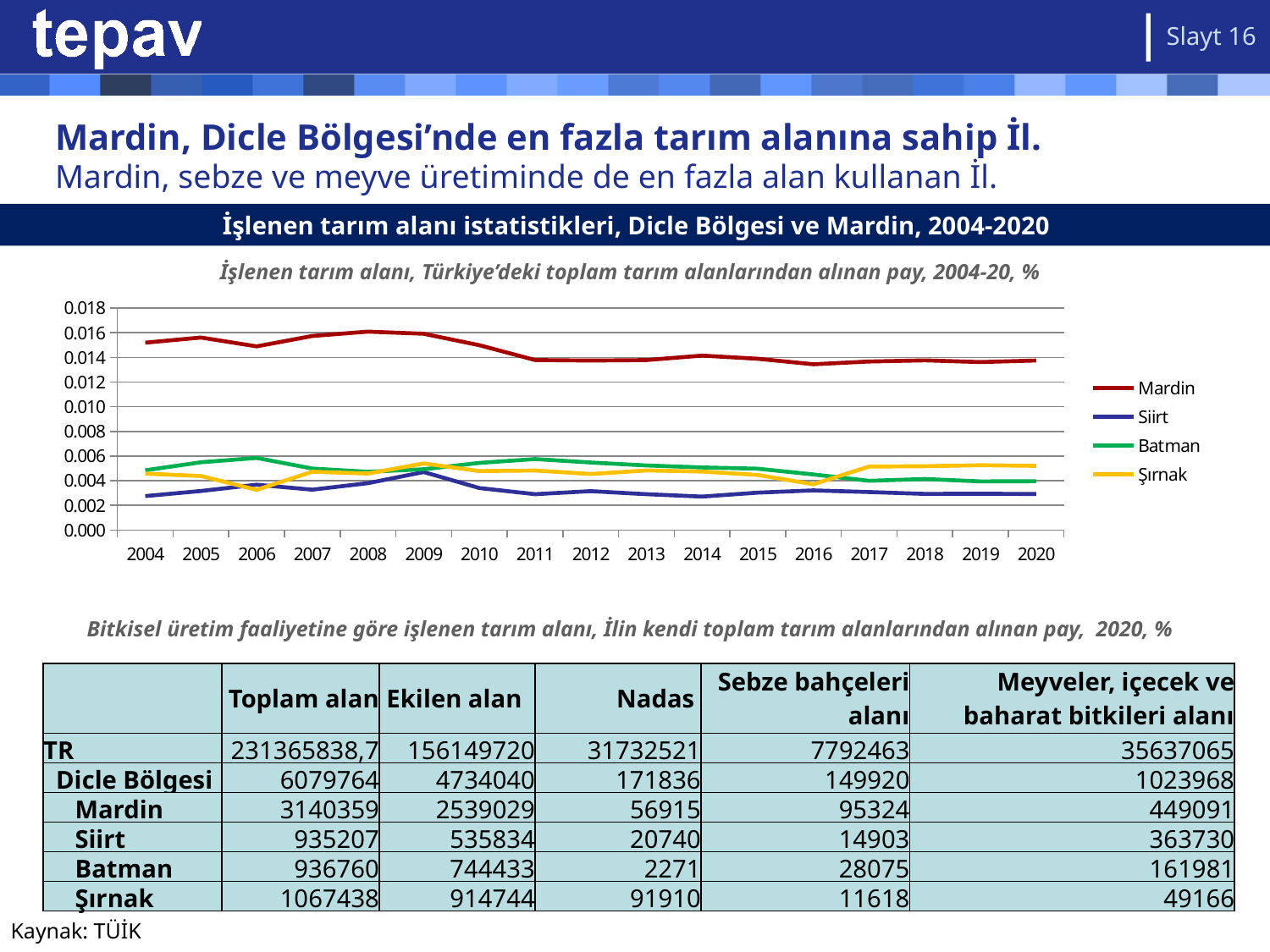
Is the value for Şırnak in 2020 greater or less than 0.004? greater Does the Mardin series overall rise or fall from 2004 to 2020? fall Is the value for Mardin in 2008 greater or less than 0.014? greater Is the value for Siirt in 2004 greater or less than 0.004? less What kind of chart is shown on the slide? line chart What colour is the Mardin line in the chart? red In 2020, which is larger on the line chart: the value for Şırnak or the value for Siirt? Şırnak In 2010, which is larger on the line chart: the value for Mardin or the value for Siirt? Mardin Which series has the lowest value in 2004 on the line chart? Siirt How many series does the legend of the line chart list? 4 How many years are plotted along the x axis of the line chart? 17 Which series has the highest value in 2020 on the line chart? Mardin